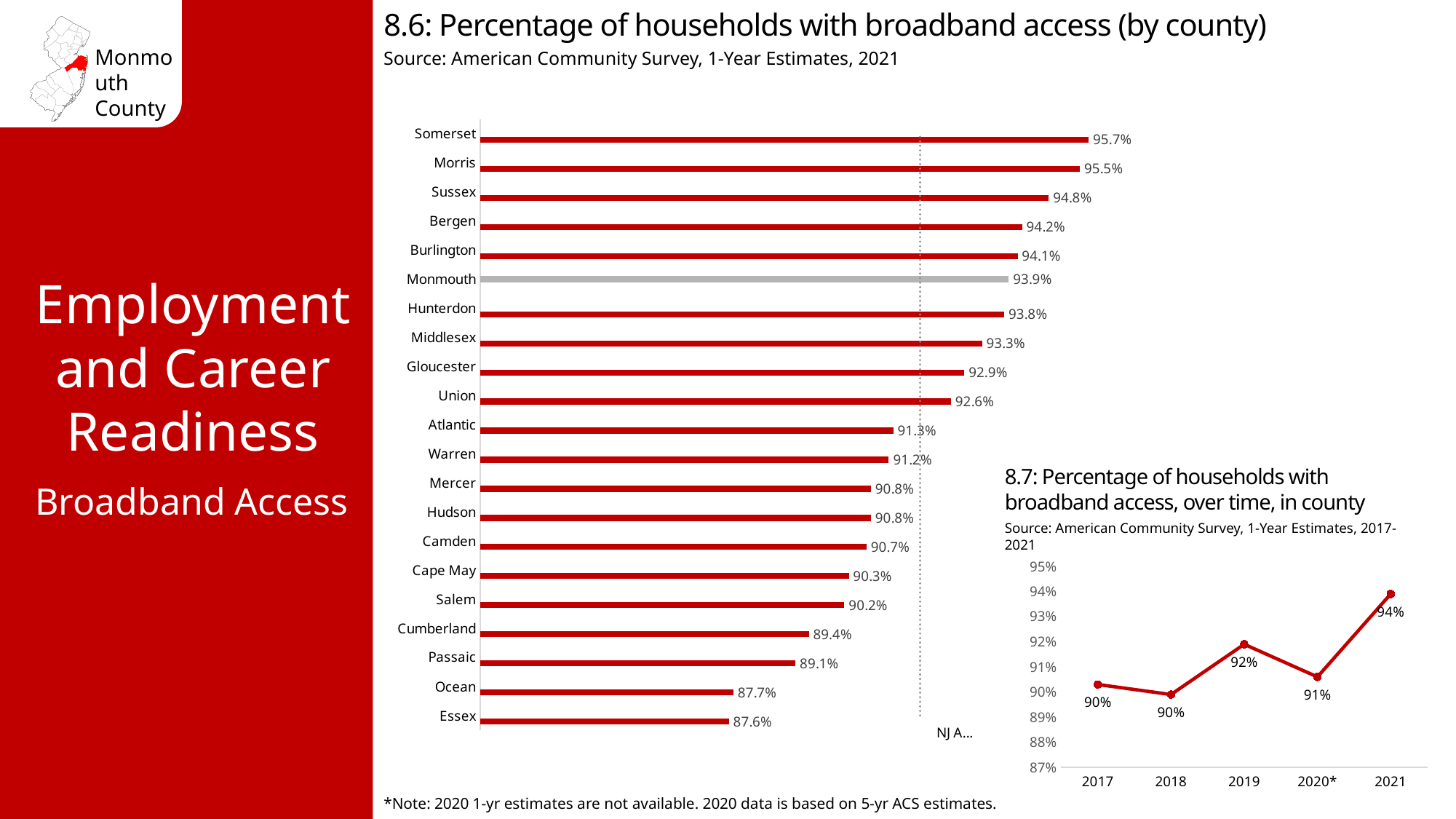
In chart 8.6, what is the value for Passaic? 89.1% In chart 8.6, which county has the lowest percentage of households with broadband access? Essex In chart 8.6, which county has the highest percentage of households with broadband access? Somerset In chart 8.6, what is the difference between Somerset's value and Essex's value? 8.1% What type of chart is chart 8.6? Bar chart In chart 8.7, what is the value for 2021? 94% In chart 8.6, which county's bar is shown in grey rather than red? Monmouth In chart 8.7, what is the difference between the 2021 value and the 2020* value? 3% In chart 8.6, what is the percentage of households with broadband access in Monmouth County? 93.9% In chart 8.6, which county has a higher value, Bergen or Burlington? Bergen In chart 8.7, how many years are plotted? 5 In chart 8.6, how many counties are shown? 21